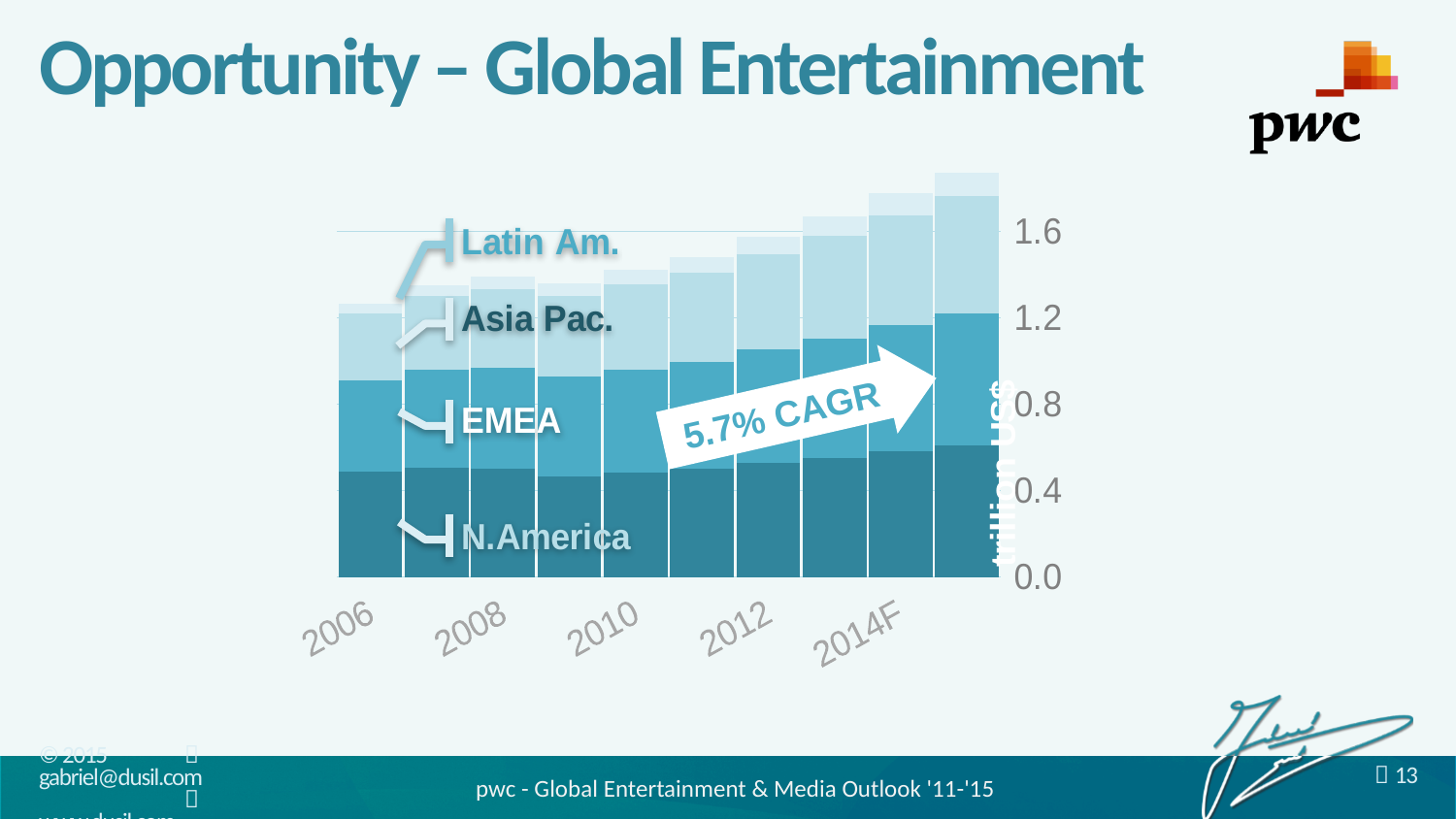
Which labelled year has the lowest total bar? 2006 What kind of chart is shown on the slide? Stacked bar chart Is the total value for 2014F greater or less than 1.6 trillion US$? greater Which region contributes the smallest segment in each year? Latin Am. Which region forms the bottom segment of each stacked bar? N.America Which region forms the top segment of each stacked bar? Latin Am. Is the total for 2014F larger or smaller than the total for 2006? larger Is the total value for 2006 greater or less than 0.8 trillion US$? greater Do the total bar heights rise or fall from 2006 to 2014F? Rise What CAGR is annotated on the chart? 5.7% CAGR How many regional series are stacked in the chart? 4